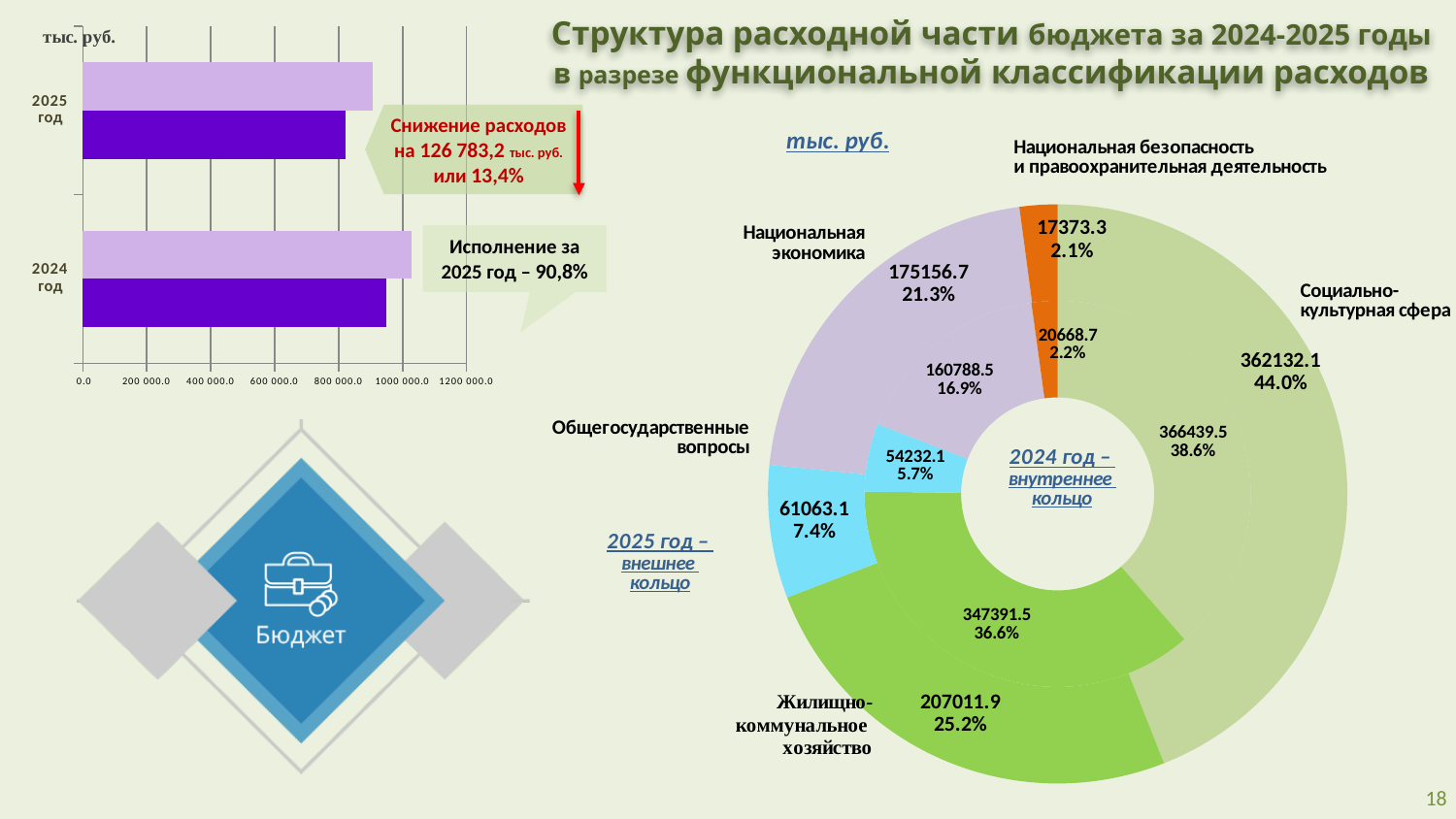
In the doughnut chart, which category has the smallest share in the outer ring (2025 год)? Национальная безопасность и правоохранительная деятельность In the doughnut chart, which is larger: the 2025 value for Общегосударственные вопросы (61063.1) or the 2024 value (54232.1)? 2025 value (61063.1) What kind of chart is the chart on the left of the slide? bar chart In the doughnut chart, which category has the largest share in the outer ring (2025 год)? Социально-культурная сфера What kind of chart is the chart on the right of the slide? doughnut chart In the doughnut chart, what share does Жилищно-коммунальное хозяйство have in the outer ring (2025 год)? 25.2% How many categories are labelled in the doughnut chart? 5 In the doughnut chart, what is the value for Национальная безопасность и правоохранительная деятельность in the inner ring (2024 год)? 20668.7 In the doughnut chart, what is the difference between the 2025 value (outer ring) and the 2024 value (inner ring) for Жилищно-коммунальное хозяйство? 140379.6 In the bar chart on the left, is the value of the light purple bar for 2024 год greater or less than 1000 000.0? greater In the doughnut chart, what is the value for Национальная экономика in the outer ring (2025 год)? 175156.7 In the doughnut chart, what is the value for Социально-культурная сфера in the outer ring (2025 год)? 362132.1